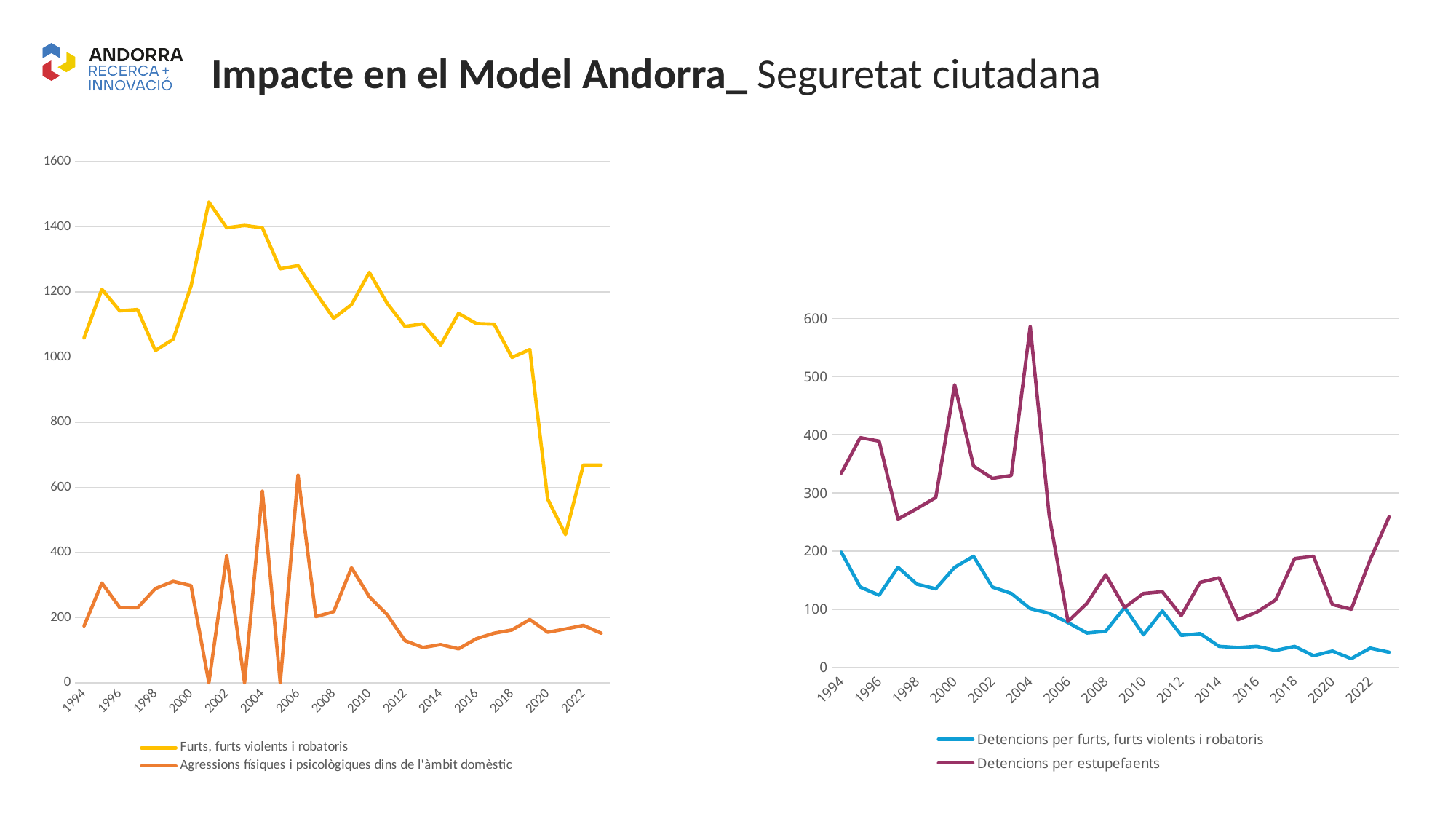
In the chart on the right, in which year does the series 'Detencions per estupefaents' reach its highest value? 2004 In the chart on the left, what colour is the line for 'Agressions físiques i psicològiques dins de l'àmbit domèstic'? orange In the chart on the right, in which year does the series 'Detencions per furts, furts violents i robatoris' reach its highest value? 1994 In the chart on the right, which series has the larger value in 2000, 'Detencions per furts, furts violents i robatoris' or 'Detencions per estupefaents'? Detencions per estupefaents In the chart on the left, is the value for 'Furts, furts violents i robatoris' in 2021 greater or less than 600? less In the chart on the right, does the series 'Detencions per furts, furts violents i robatoris' generally rise or fall from 1994 to 2022? fall How many series does the legend of the chart on the right of the slide list? 2 In the chart on the right, is the value for 'Detencions per estupefaents' in 2004 greater or less than 500? greater In the chart on the left, in which year does the series 'Furts, furts violents i robatoris' reach its highest value? 2001 What kind of chart is the chart on the left of the slide? line chart In the chart on the right, is the value for 'Detencions per furts, furts violents i robatoris' in 2022 greater or less than 100? less